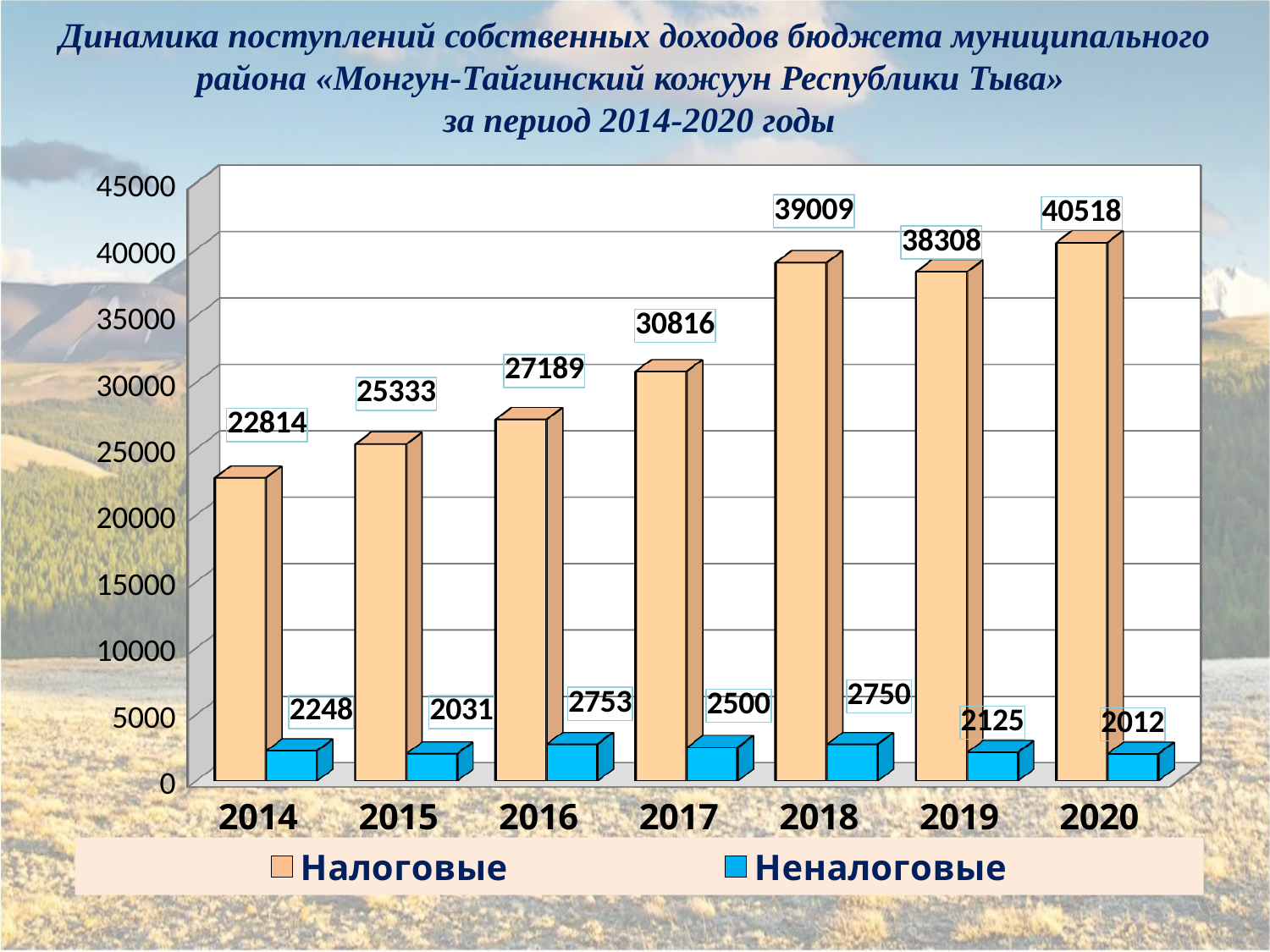
What is the difference between the Налоговые values for 2018 and 2019? 701 Is the Налоговые value for 2017 greater or less than 30000? greater How many series does the legend list? 2 What is the value of Неналоговые for 2018? 2750 What is the value of Налоговые for 2014? 22814 What kind of chart is shown on the slide? bar chart What is the value of Налоговые for 2020? 40518 How many years are shown on the x axis? 7 Which year has the highest Налоговые value? 2020 Which is larger, the Неналоговые value for 2016 or for 2017? 2016 Which year has the lowest Неналоговые value? 2020 Do the Налоговые values rise or fall from 2014 to 2018? rise